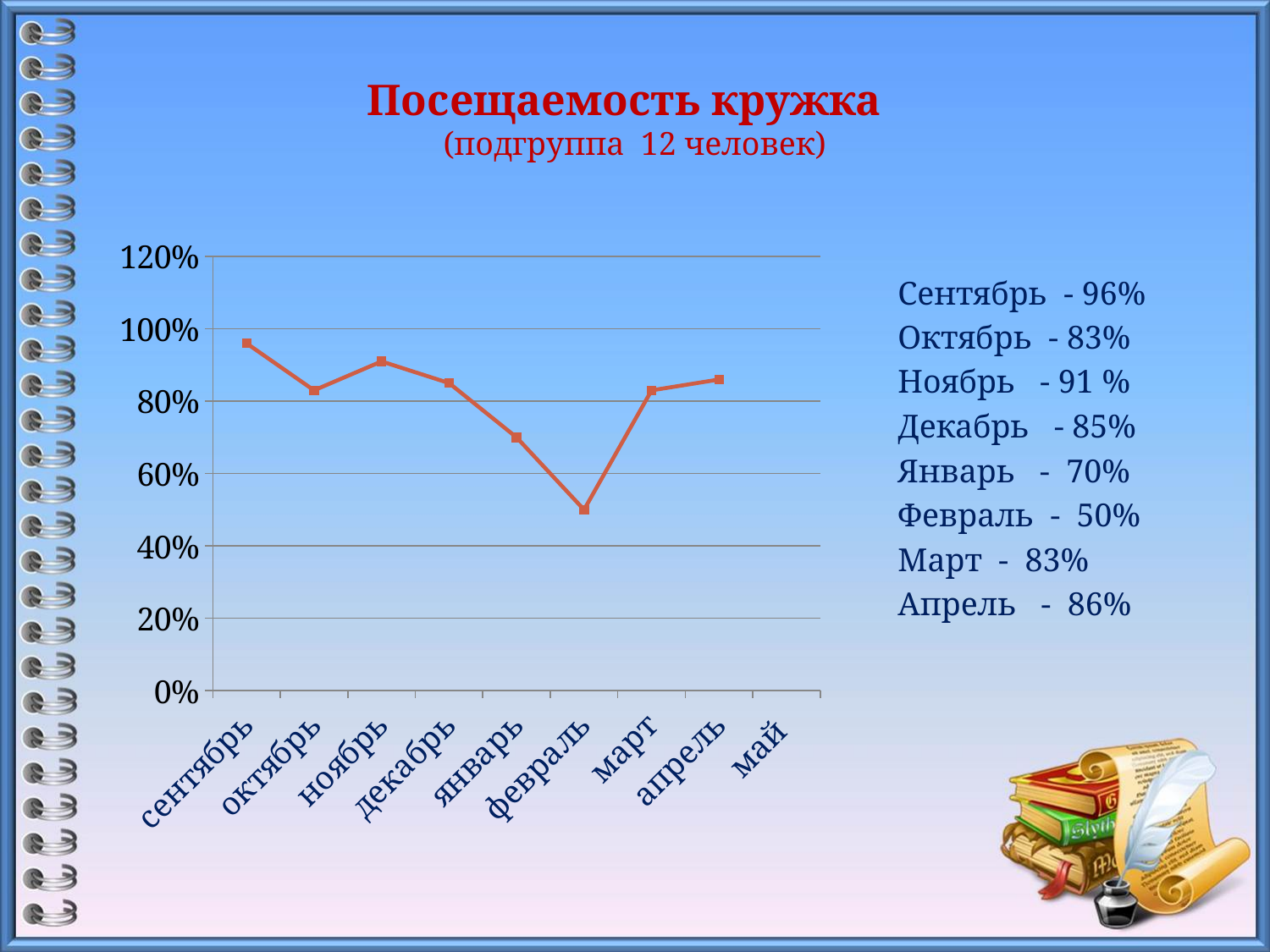
How many months have a plotted data point on the line? 8 What is the attendance value for апрель (April)? 86% What kind of chart is shown on the slide? line chart Which month has the lowest attendance? февраль What is the attendance value for сентябрь (September)? 96% Which month has higher attendance, ноябрь or декабрь? ноябрь What is the difference between the attendance in сентябрь (96%) and февраль (50%)? 46% Does attendance rise or fall from сентябрь to февраль? fall What is the attendance value for февраль (February)? 50% What is the title of the chart on the slide? Посещаемость кружка Is the value for январь greater or less than 80%? less Which month has the highest attendance? сентябрь